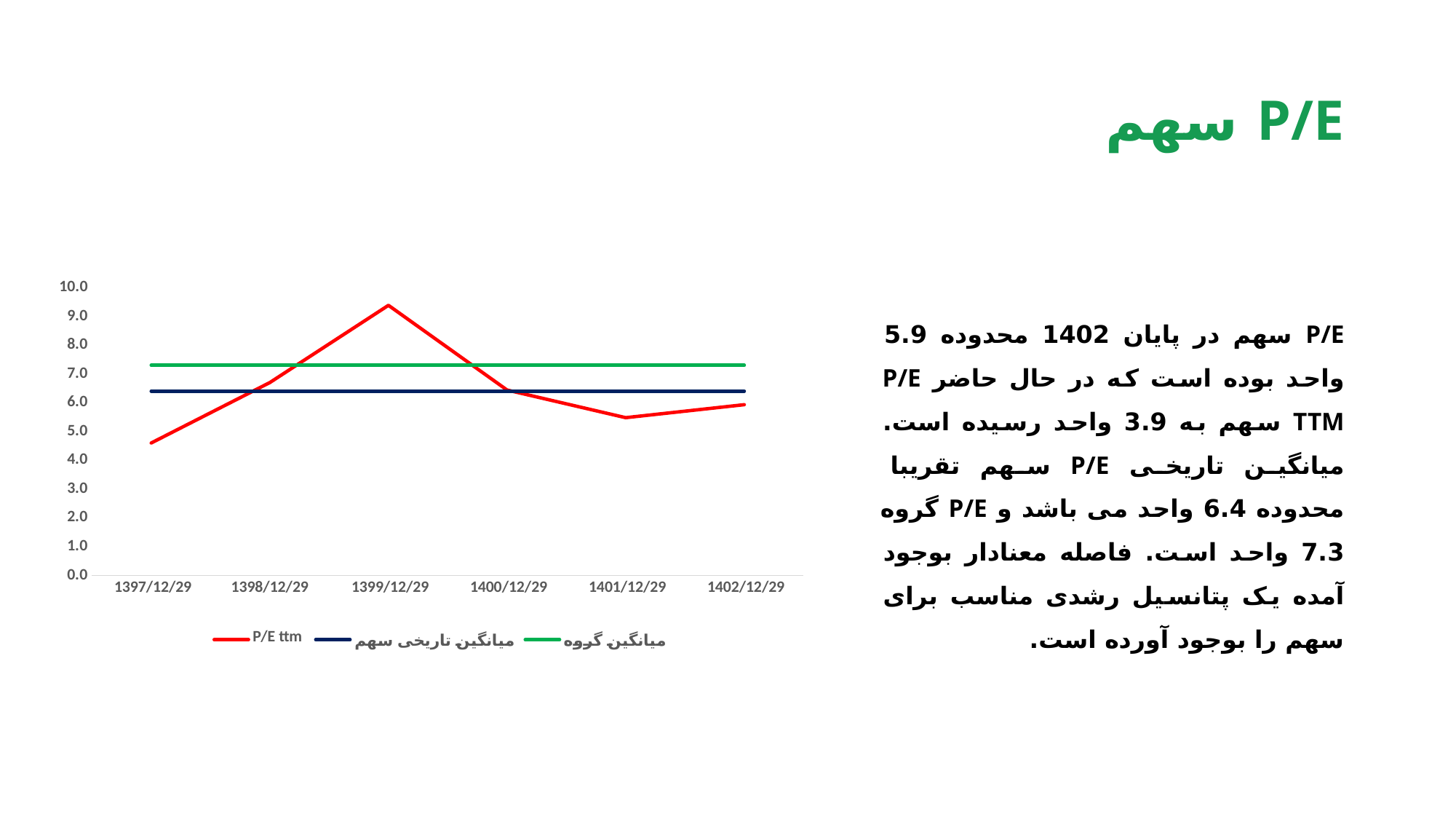
Which line is higher on the chart, میانگین گروه or میانگین تاریخی سهم? میانگین گروه Does the P/E ttm line rise or fall between 1399/12/29 and 1401/12/29? fall At which date is the P/E ttm line at its lowest value? 1397/12/29 Is the P/E ttm value at 1401/12/29 greater or less than 6.0? less What kind of chart is shown on the slide? line chart How many dates are shown on the x axis of the chart? 6 Is the P/E ttm value at 1399/12/29 greater or less than 8.0? greater Is the P/E ttm value at 1397/12/29 greater or less than 5.0? less What colour is the P/E ttm line in the chart? red How many series does the chart legend list? 3 At which date does the P/E ttm line reach its highest value? 1399/12/29